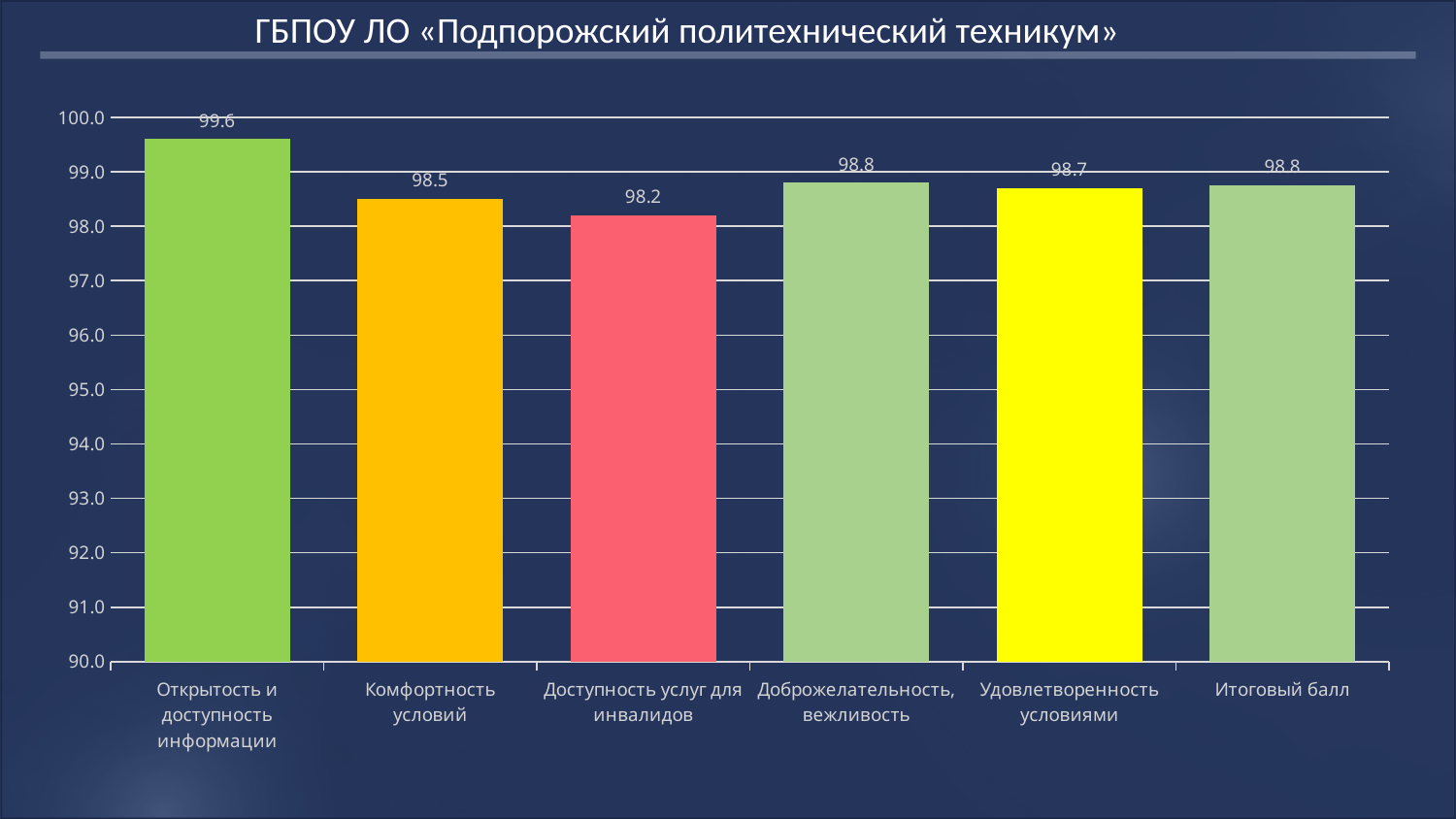
What is the value for Доступность услуг для инвалидов? 98.2 What is the difference between the values for Открытость и доступность информации and Доступность услуг для инвалидов? 1.4 Which category has the lowest value? Доступность услуг для инвалидов Is the value for Комфортность условий greater or less than 97.0? greater What kind of chart is shown on the slide? bar chart What is the value for Открытость и доступность информации? 99.6 What is the value for Удовлетворенность условиями? 98.7 What is the title of the slide? ГБПОУ ЛО «Подпорожский политехнический техникум» Which category has the highest value? Открытость и доступность информации Which is larger, the value for Комфортность условий or the value for Доброжелательность, вежливость? Доброжелательность, вежливость What is the value for Итоговый балл? 98.8 How many categories are shown on the x axis? 6